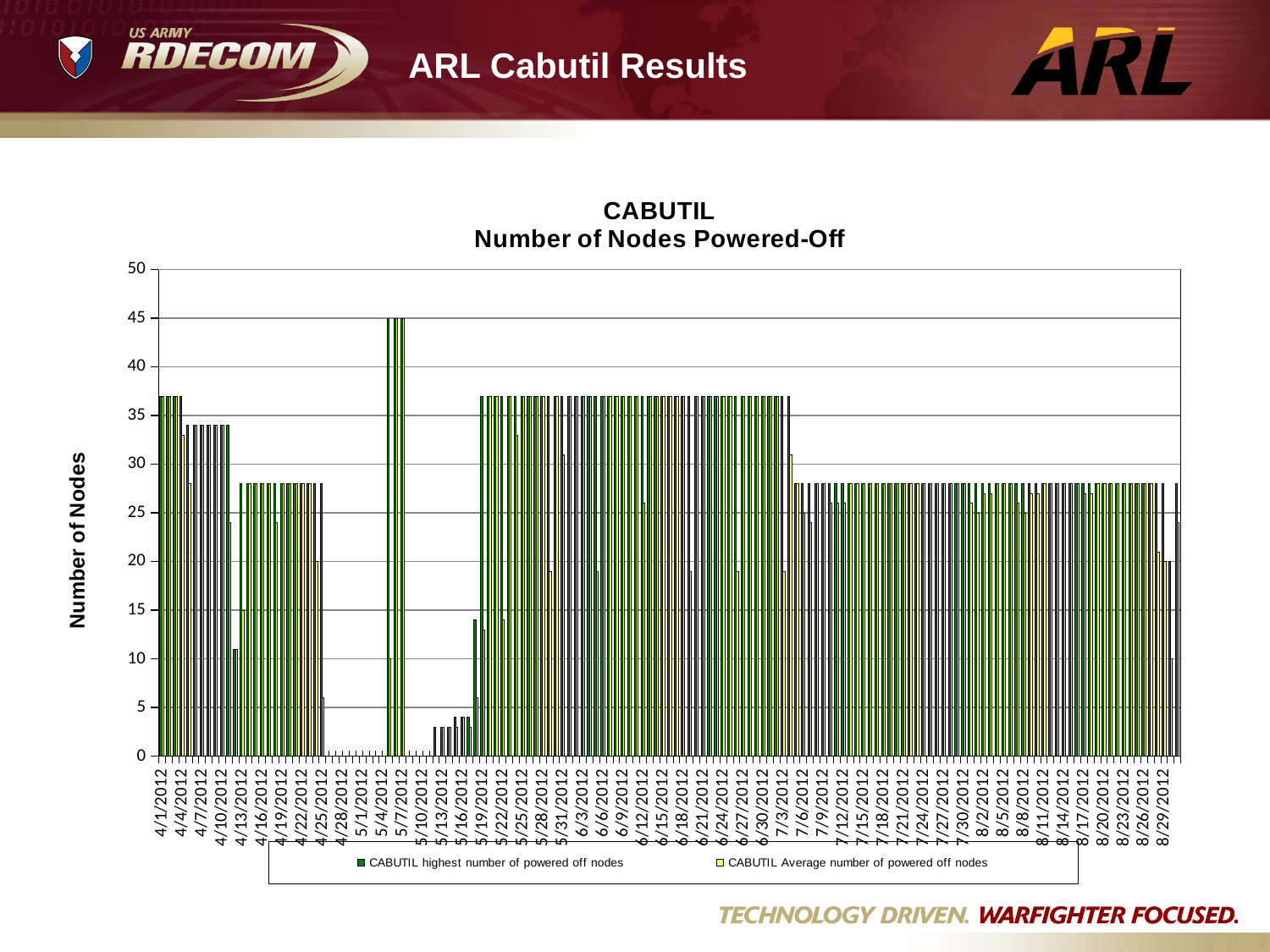
Is the value for 'CABUTIL highest number of powered off nodes' on 5/7/2012 greater or less than 40? greater Is the value for 'CABUTIL highest number of powered off nodes' on 8/2/2012 greater or less than 30? less Between 4/1/2012 and 4/28/2012, do the 'CABUTIL highest number of powered off nodes' values rise or fall? fall What is the title of the chart? CABUTIL Number of Nodes Powered-Off What is the label of the vertical axis? Number of Nodes How many series does the legend list? 2 Is the value for 'CABUTIL highest number of powered off nodes' on 4/1/2012 greater or less than 35? greater Which date has the larger 'CABUTIL highest number of powered off nodes' value, 5/7/2012 or 6/3/2012? 5/7/2012 What type of chart is shown on the slide? bar chart What is the maximum value reached by the 'CABUTIL highest number of powered off nodes' series? 45 Which date has the larger 'CABUTIL highest number of powered off nodes' value, 4/1/2012 or 4/16/2012? 4/1/2012